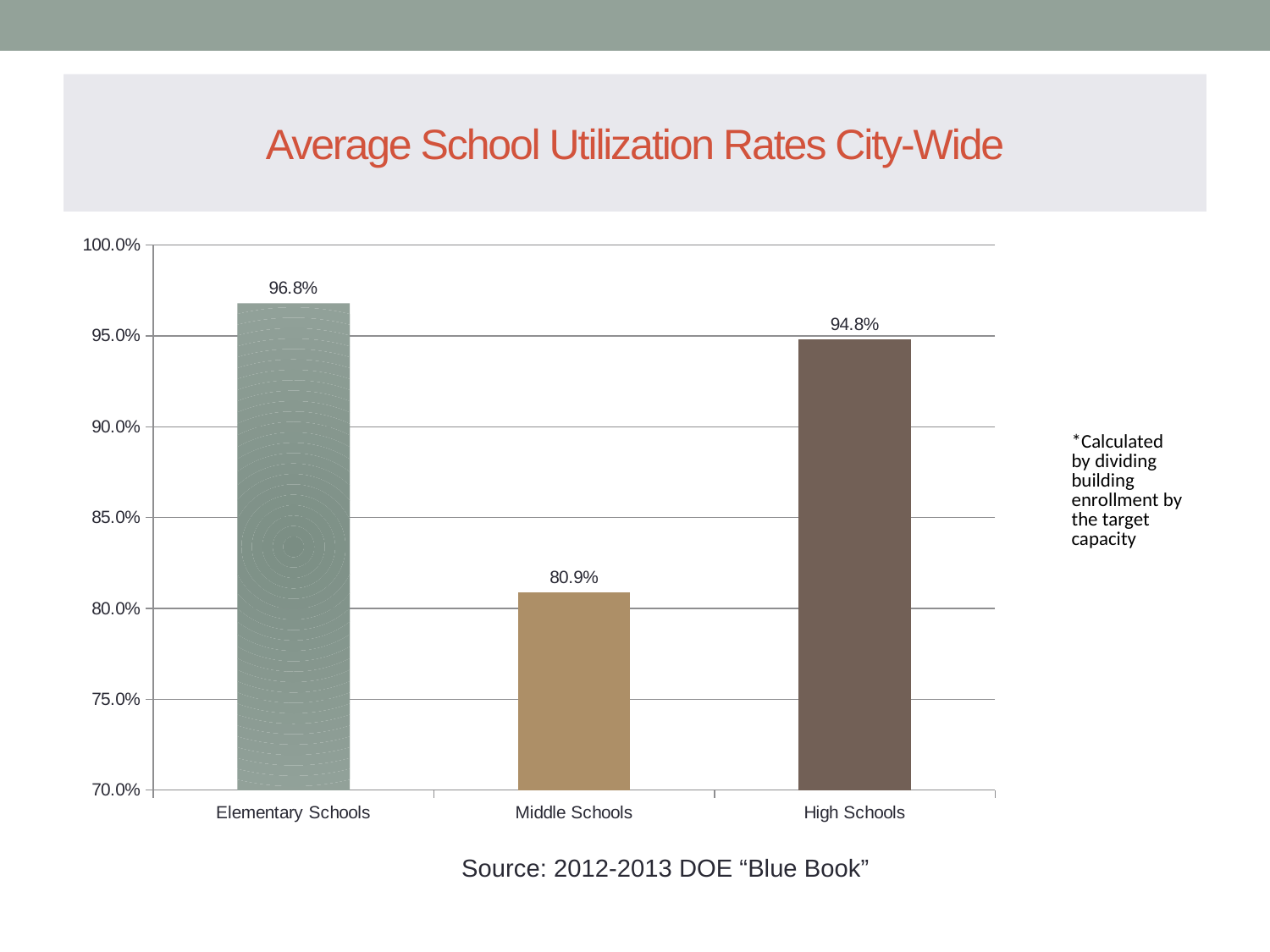
What is the average utilization rate for High Schools? 94.8% What kind of chart is shown on the slide? Bar chart Which has a higher utilization rate, Middle Schools or High Schools? High Schools Is the value for Middle Schools greater or less than 85.0%? less What is the difference between the utilization rates of Elementary Schools and Middle Schools? 15.9% What is the difference between the utilization rates of Elementary Schools and High Schools? 2.0% Which school type has the lowest average utilization rate? Middle Schools How many school types are shown in the chart? 3 What is the average utilization rate for Middle Schools? 80.9% What is the title of the chart? Average School Utilization Rates City-Wide Which school type has the highest average utilization rate? Elementary Schools What is the average utilization rate for Elementary Schools? 96.8%